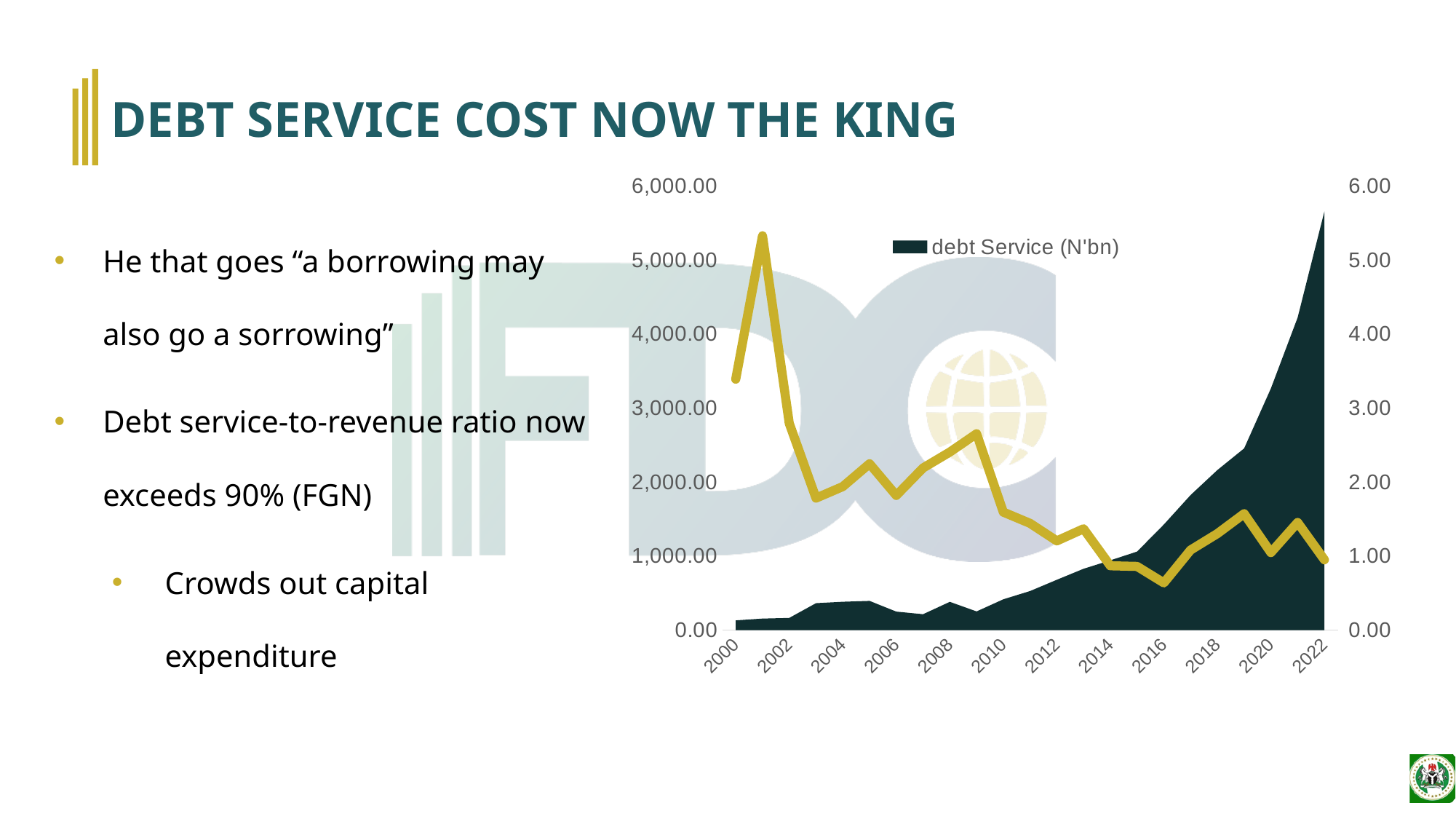
What kind of chart is shown on the slide? An area chart with a line overlay Which year has the lowest debt service value in the chart? 2000 Is the debt service value for 2020 greater or less than 2,000.00? greater Which year has the highest debt service value in the chart? 2022 Which is larger: the gold line's value in 2001 or in 2022? 2001 Is the gold line's value in 2001 greater or less than 5.00 on the right axis? greater What is the series name shown in the chart legend? debt Service (N'bn) Does the debt service area generally rise or fall from 2000 to 2022? Rise Is the debt service value for 2010 greater or less than 1,000.00? less How many year labels are shown on the x axis of the chart? 12 How many series does the chart legend list? 1